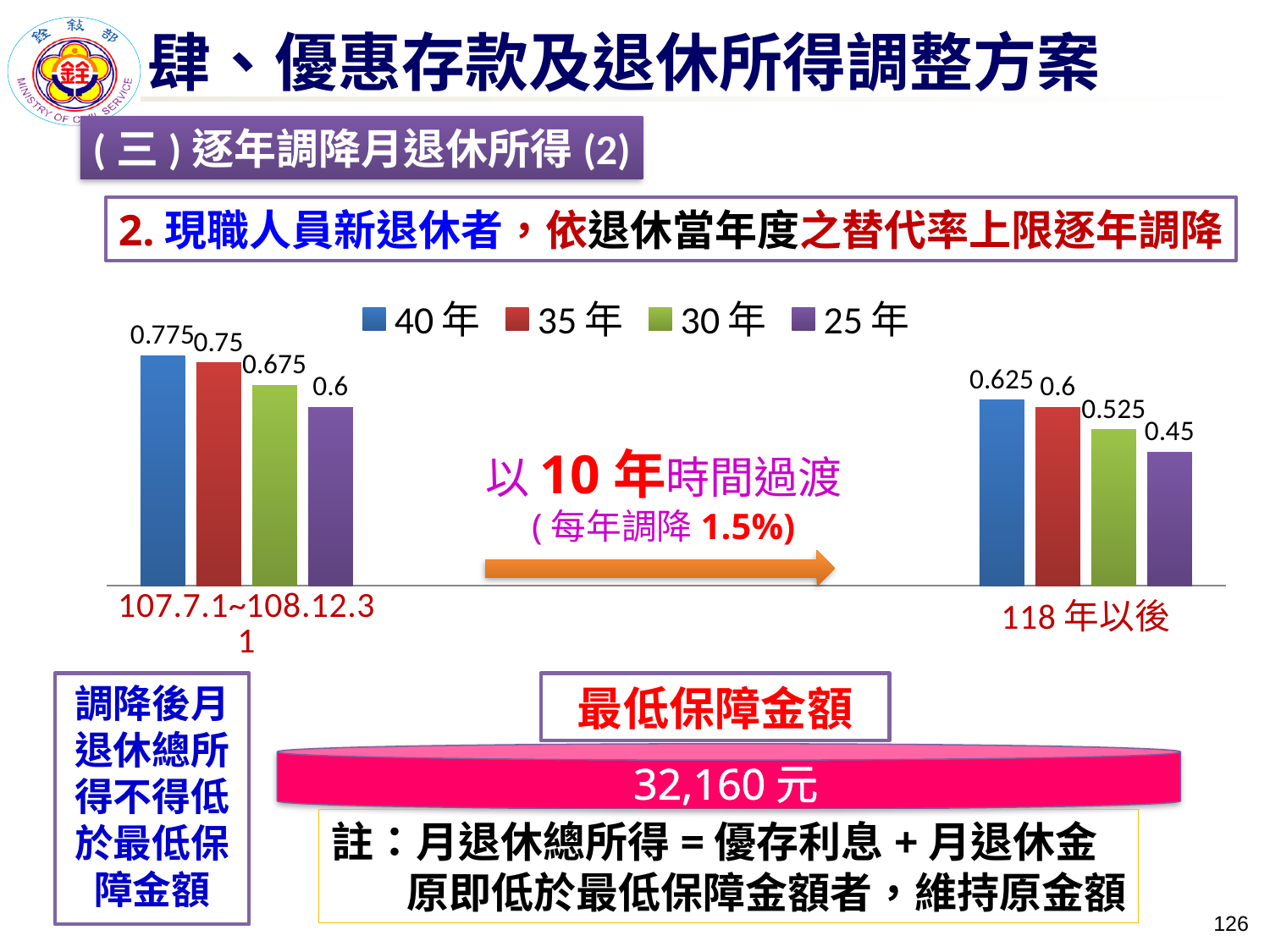
What is the value for the 30 年 series in the 118 年以後 category? 0.525 Which is larger: the 30 年 value in 107.7.1~108.12.31 or the 40 年 value in 118 年以後? 30 年 value in 107.7.1~108.12.31 What is the difference between the 40 年 values in the 107.7.1~108.12.31 category and the 118 年以後 category? 0.15 How many categories are shown on the x axis? 2 Do the values for each series rise or fall from the 107.7.1~108.12.31 category to the 118 年以後 category? Fall What is the value for the 35 年 series in the 107.7.1~108.12.31 category? 0.75 How many series does the legend list? 4 What is the value for the 25 年 series in the 118 年以後 category? 0.45 Which series has the highest value in the 118 年以後 category? 40 年 What kind of chart is shown on the slide? Bar chart Which series has the lowest value in the 107.7.1~108.12.31 category? 25 年 What is the value for the 40 年 series in the 107.7.1~108.12.31 category? 0.775